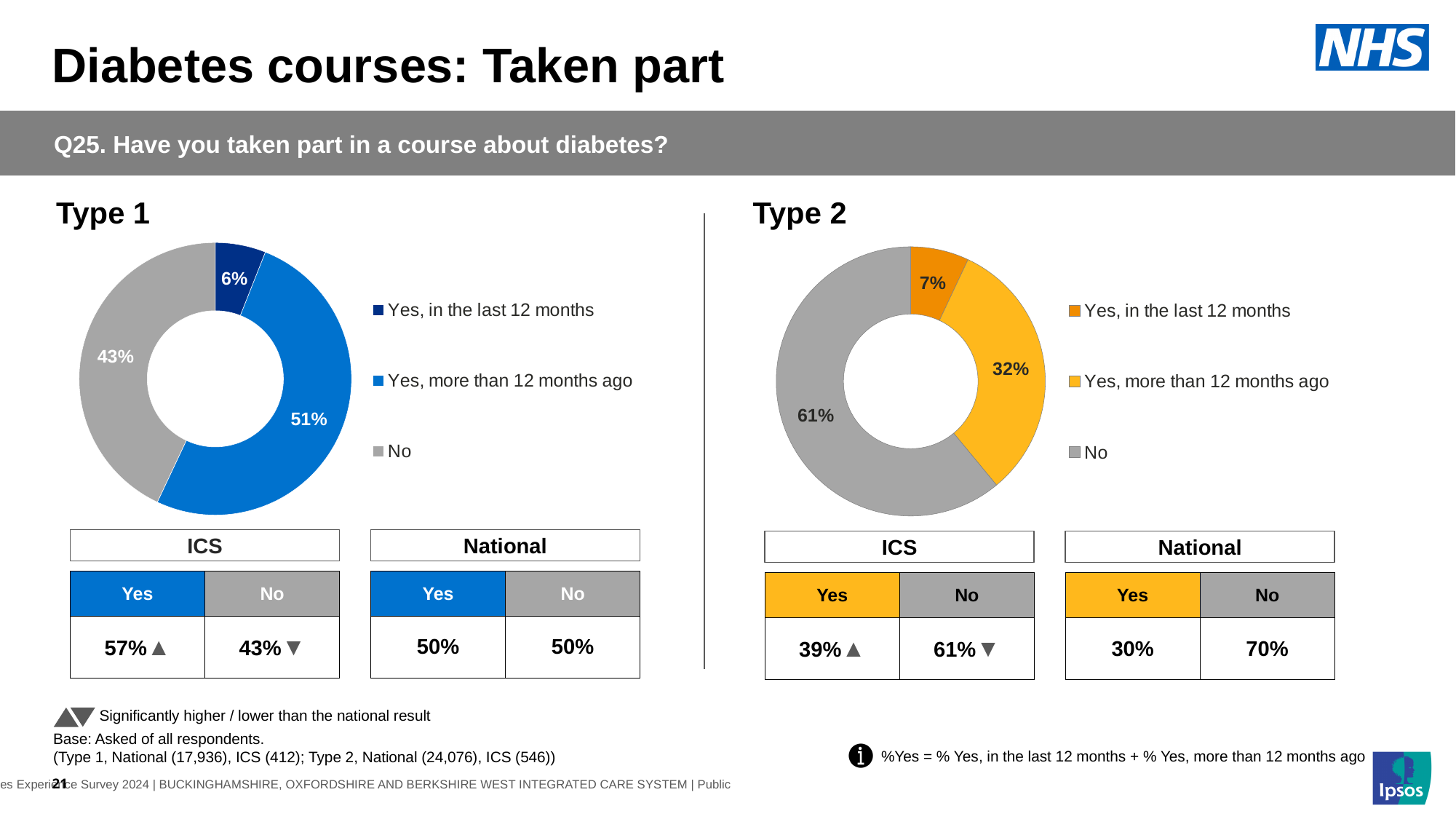
In the Type 1 chart, what percentage of respondents answered 'Yes, in the last 12 months'? 6% In the Type 2 chart, what is the difference in percentage points between 'No' and 'Yes, more than 12 months ago'? 29 percentage points In the Type 2 chart, which category has the smallest share? Yes, in the last 12 months In the Type 1 chart, which category has the largest share? Yes, more than 12 months ago In the Type 1 chart, which is larger: the share for 'No' or the share for 'Yes, more than 12 months ago'? Yes, more than 12 months ago What kind of chart is used to show the Type 1 results? Doughnut chart In the Type 2 chart, what percentage of respondents answered 'Yes, more than 12 months ago'? 32% In the Type 2 chart, what percentage of respondents answered 'No'? 61% How many categories does the legend of the Type 2 chart list? 3 What colour represents 'No' in the Type 2 chart? Grey In the Type 1 chart, what is the combined share of the two 'Yes' categories? 57% In the Type 1 chart, what percentage of respondents answered 'Yes, more than 12 months ago'? 51%